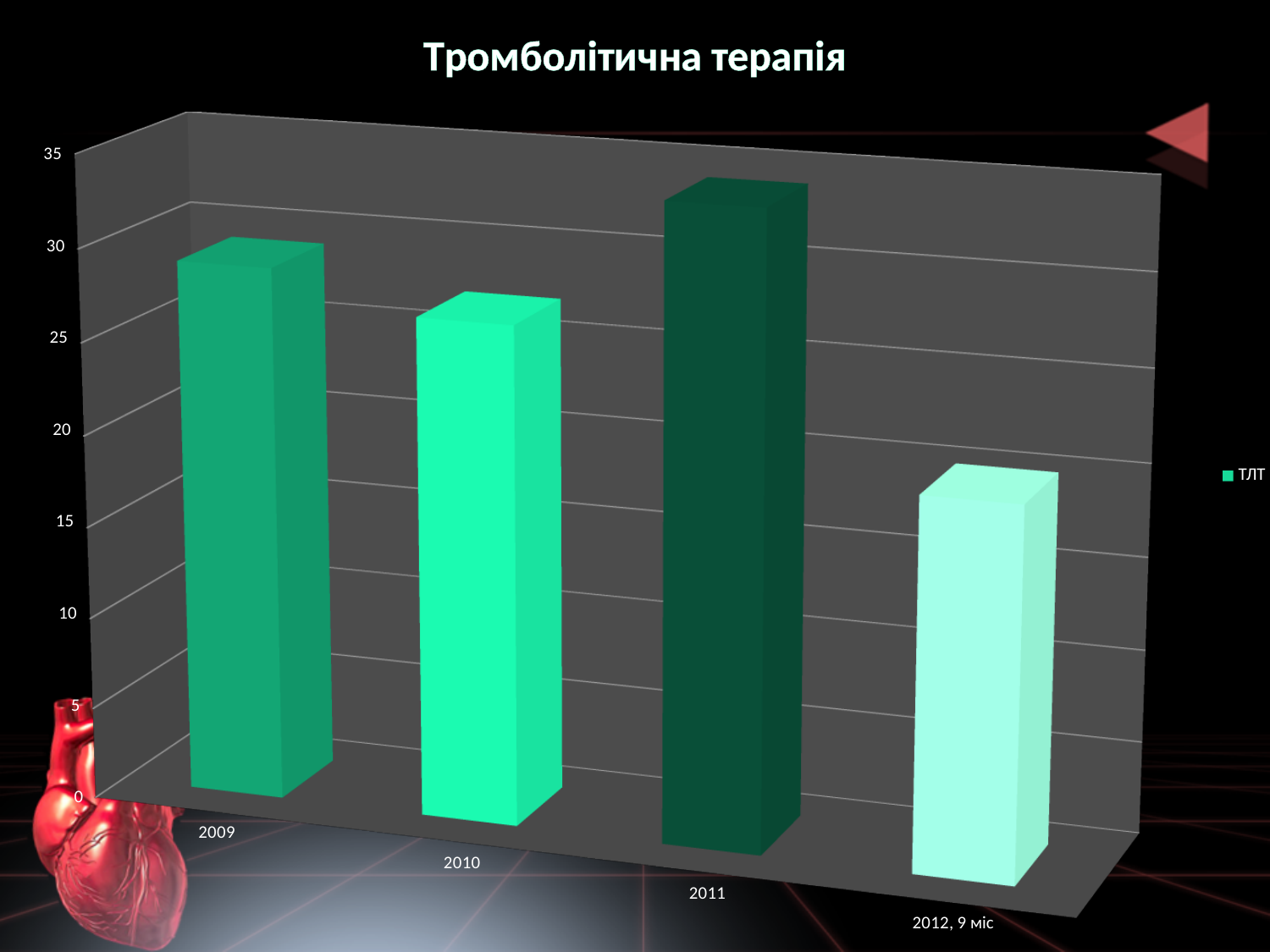
Which category has the lowest value? 2012, 9 міс Is the value for 2011 greater or less than 30? greater What is the title of the chart? Тромболітична терапія Which is larger, the value for 2009 or the value for 2010? 2009 What series name does the legend show? ТЛТ How many categories are plotted on the x axis? 4 Which category has the highest value? 2011 How many series does the legend list? 1 Is the value for 2010 greater or less than 20? greater What kind of chart is shown on the slide? bar chart Which is larger, the value for 2011 or the value for 2012, 9 міс? 2011